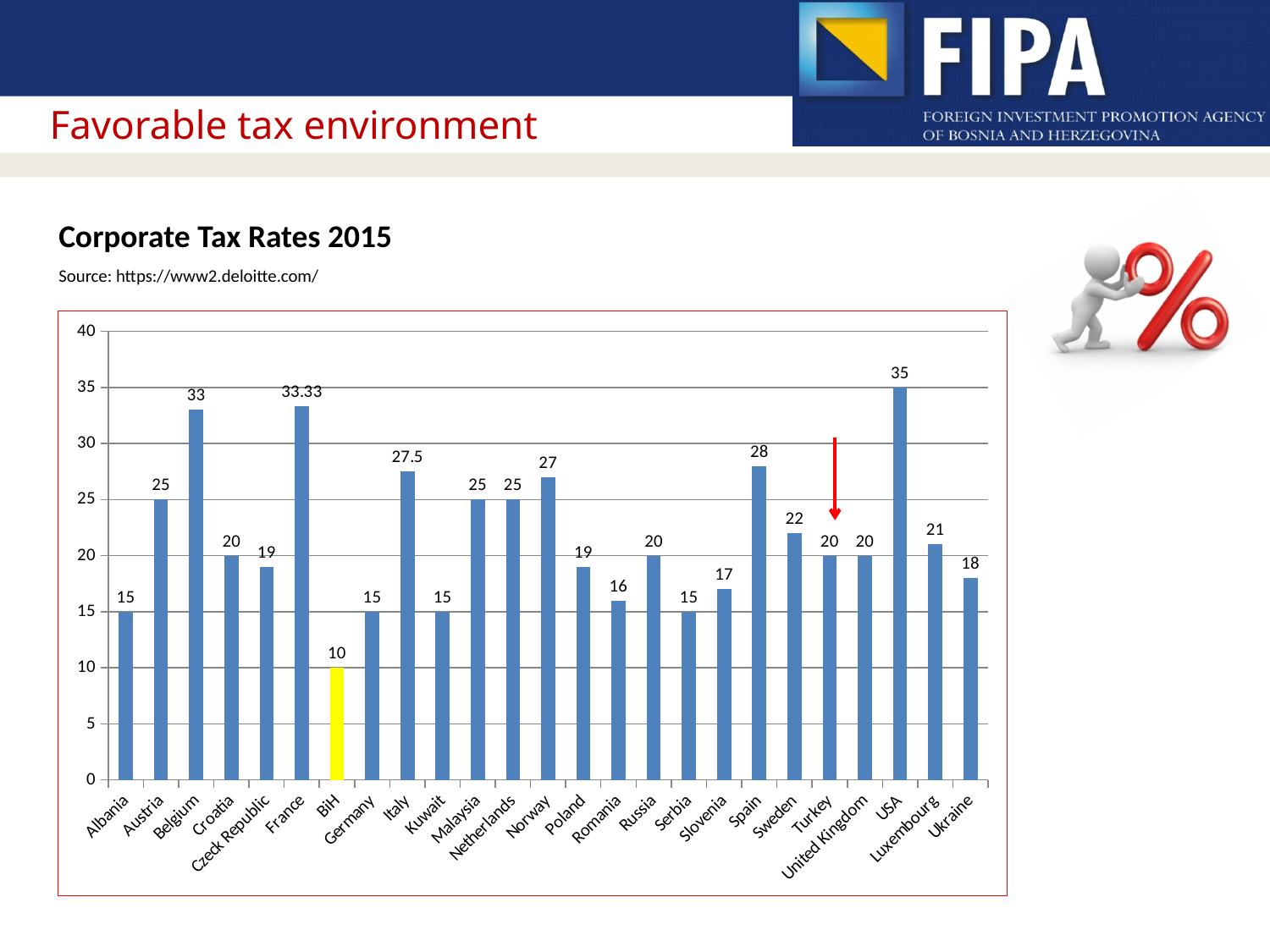
Which bar in the chart is highlighted in yellow? BiH Which has a higher corporate tax rate, Belgium or Norway? Belgium What is the difference between the corporate tax rates of USA and BiH? 25 What type of chart is used to show the corporate tax rates? Bar chart Which country has the lowest corporate tax rate in the chart? BiH Which has a higher corporate tax rate, Romania or Slovenia? Slovenia What is the corporate tax rate shown for BiH? 10 What is the corporate tax rate shown for Italy? 27.5 Which country has the highest corporate tax rate in the chart? USA What is the corporate tax rate shown for France? 33.33 What is the difference between the corporate tax rates of Spain and Sweden? 6 How many countries are shown in the chart? 25